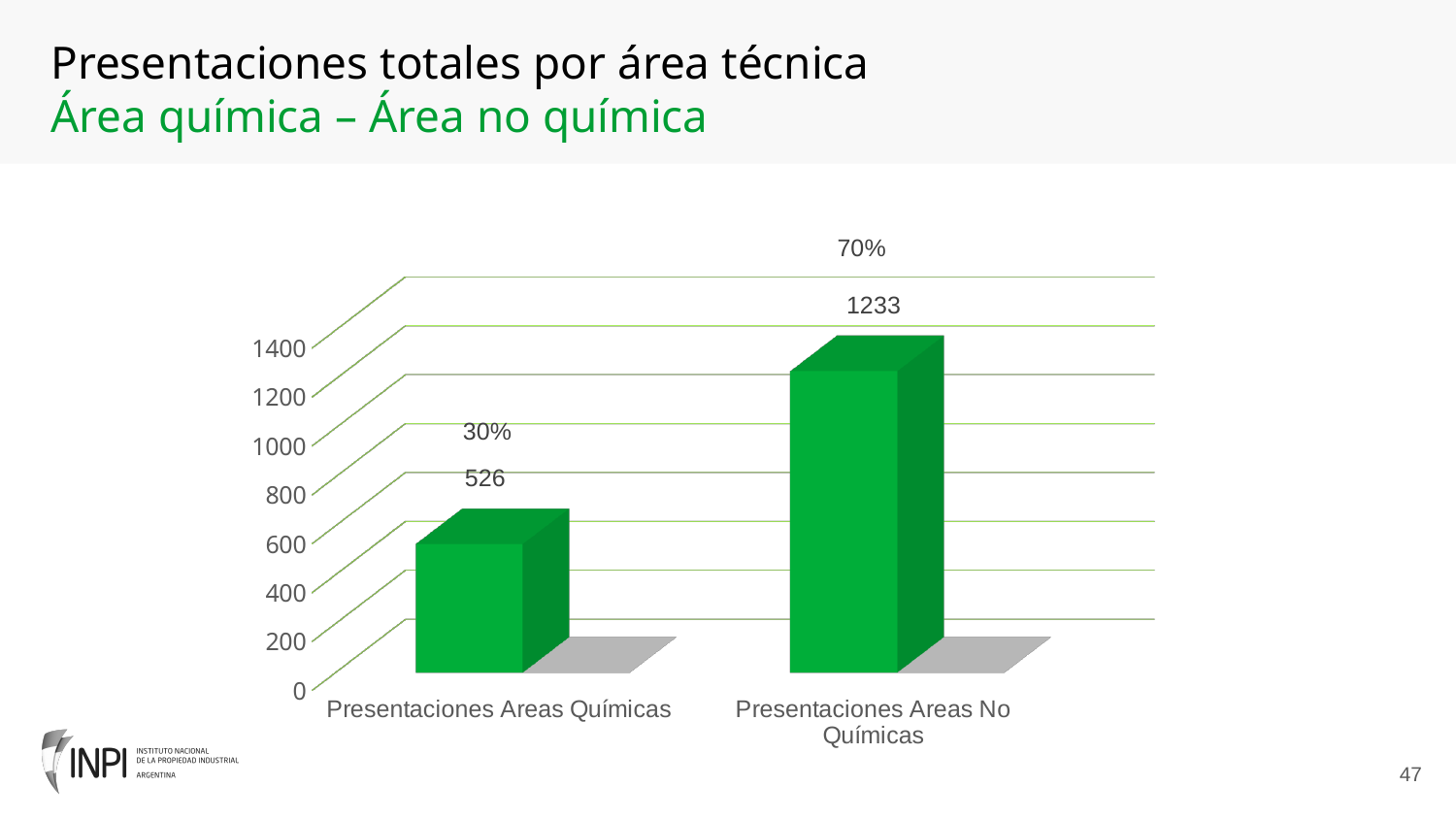
Which category has the highest value? Presentaciones Areas No Químicas What kind of chart is shown on the slide? bar chart What percentage is shown above the bar for Presentaciones Areas No Químicas? 70% Which is larger, the value for Presentaciones Areas Químicas or for Presentaciones Areas No Químicas? Presentaciones Areas No Químicas What is the difference between the values for Presentaciones Areas No Químicas and Presentaciones Areas Químicas? 707 What is the value for Presentaciones Areas No Químicas? 1233 What is the value for Presentaciones Areas Químicas? 526 What is the total of the two values shown in the chart? 1759 What percentage is shown above the bar for Presentaciones Areas Químicas? 30% Which category has the lowest value? Presentaciones Areas Químicas How many categories are shown in the chart? 2 Is the value for Presentaciones Areas Químicas greater or less than 600? less